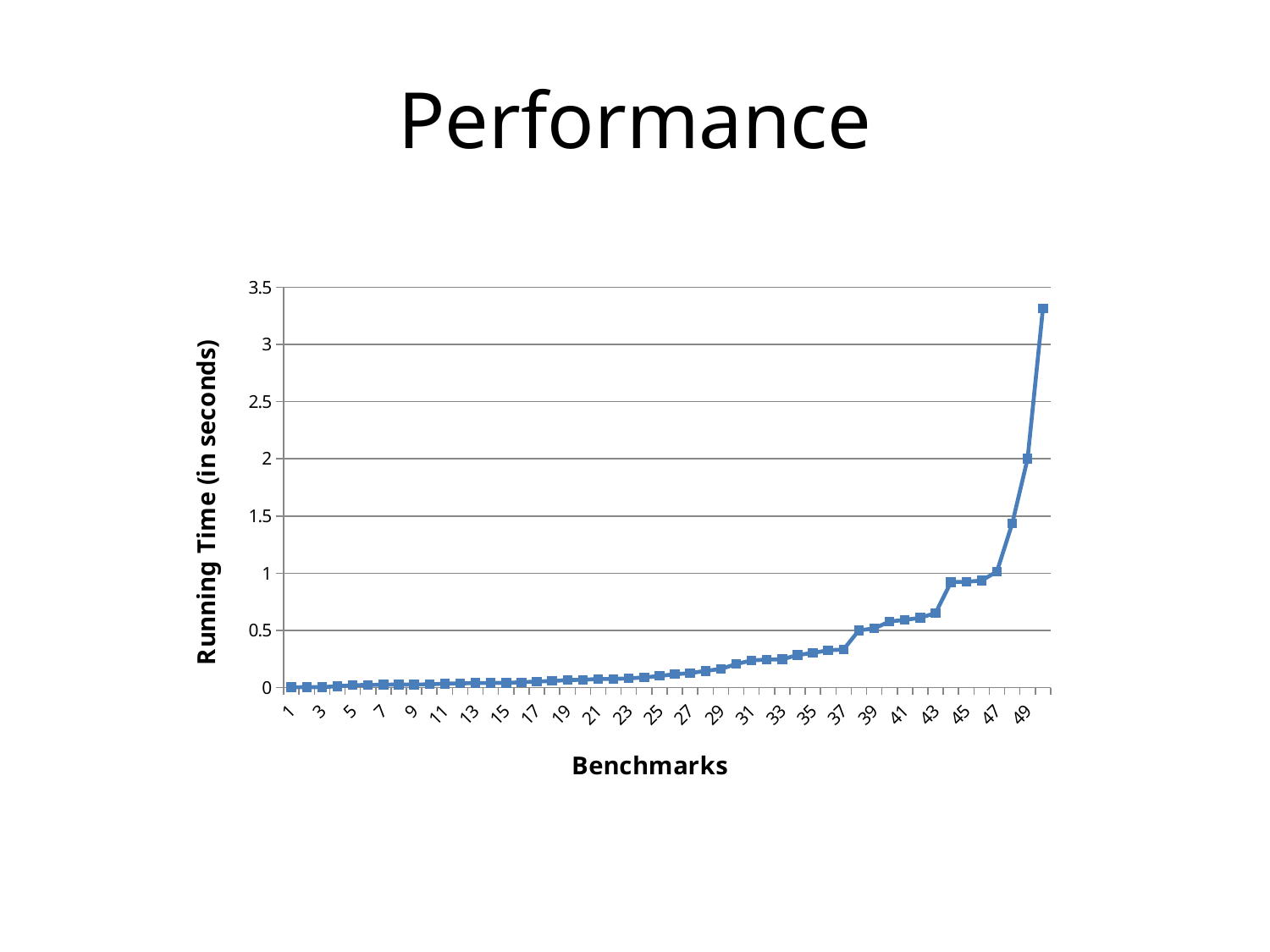
Is the running time for benchmark 37 greater or less than 0.5? less Which has the larger running time, benchmark 10 or benchmark 44? benchmark 44 Is the running time for benchmark 50 greater or less than 3? greater What kind of chart is shown on the slide? line chart Which benchmark has the highest running time? 50 Is the running time for benchmark 48 greater or less than 1? greater Do the running times rise or fall as the benchmark number increases along the x axis? rise What is the title of the slide containing the chart? Performance Which has the larger running time, benchmark 50 or benchmark 48? benchmark 50 What is the label of the vertical axis? Running Time (in seconds)